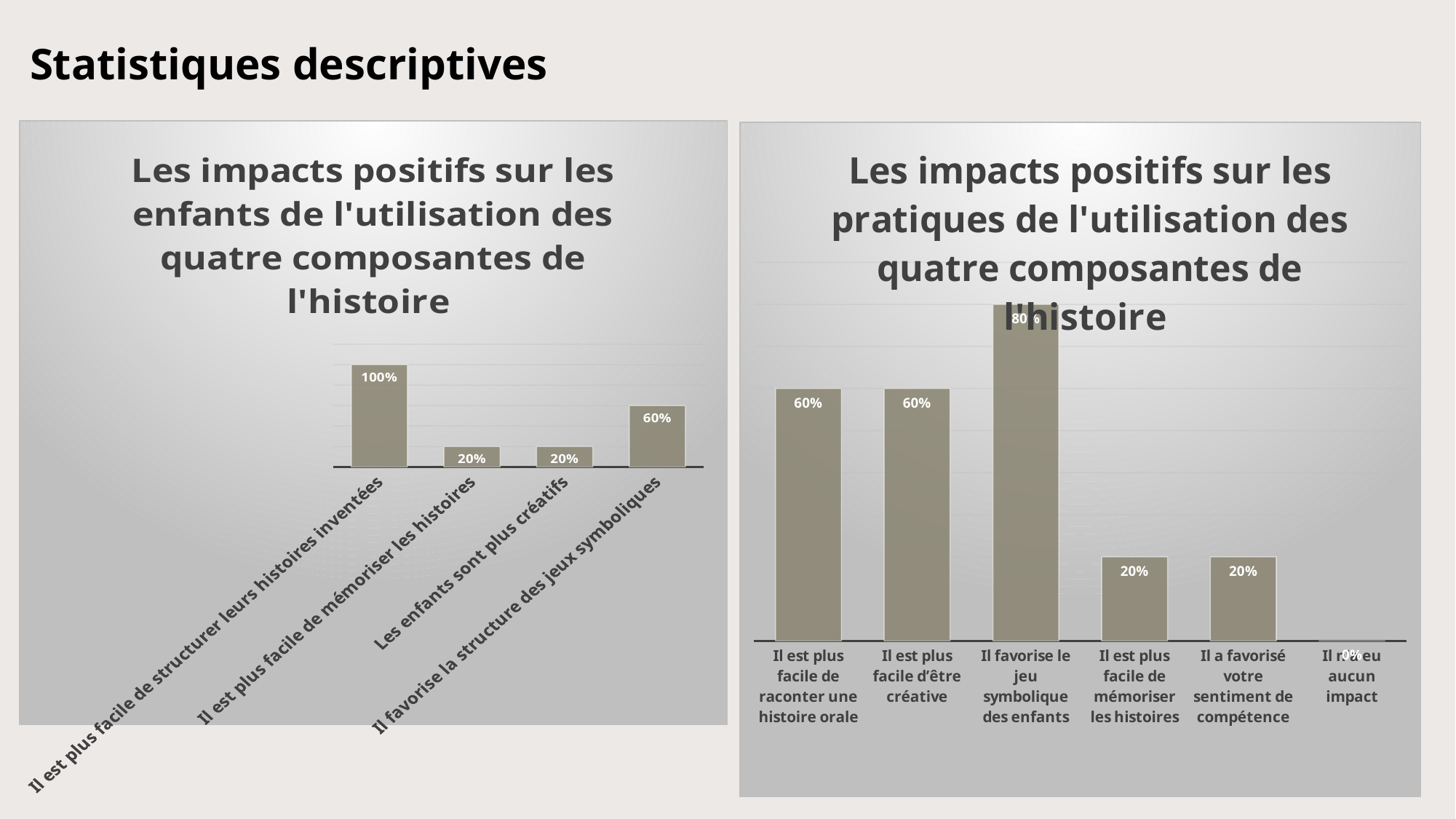
In the left chart, which category has the highest value? Il est plus facile de structurer leurs histoires inventées In the right chart, which is larger: 'Il est plus facile de raconter une histoire orale' or 'Il est plus facile de mémoriser les histoires'? Il est plus facile de raconter une histoire orale In the right chart, what is the value for 'Il a favorisé votre sentiment de compétence'? 20% In the right chart, what is the difference between 'Il favorise le jeu symbolique des enfants' and 'Il est plus facile d'être créative'? 20% In the left chart, what is the value for 'Il est plus facile de structurer leurs histoires inventées'? 100% In the left chart, what is the value for 'Il favorise la structure des jeux symboliques'? 60% In the right chart, what is the value for 'Il favorise le jeu symbolique des enfants'? 80% How many categories are shown in the right chart? 6 In the right chart, which category has the highest value? Il favorise le jeu symbolique des enfants In the left chart, what is the difference between 'Il est plus facile de structurer leurs histoires inventées' and 'Les enfants sont plus créatifs'? 80% What type of chart is the left chart? Bar chart How many categories are shown in the left chart? 4